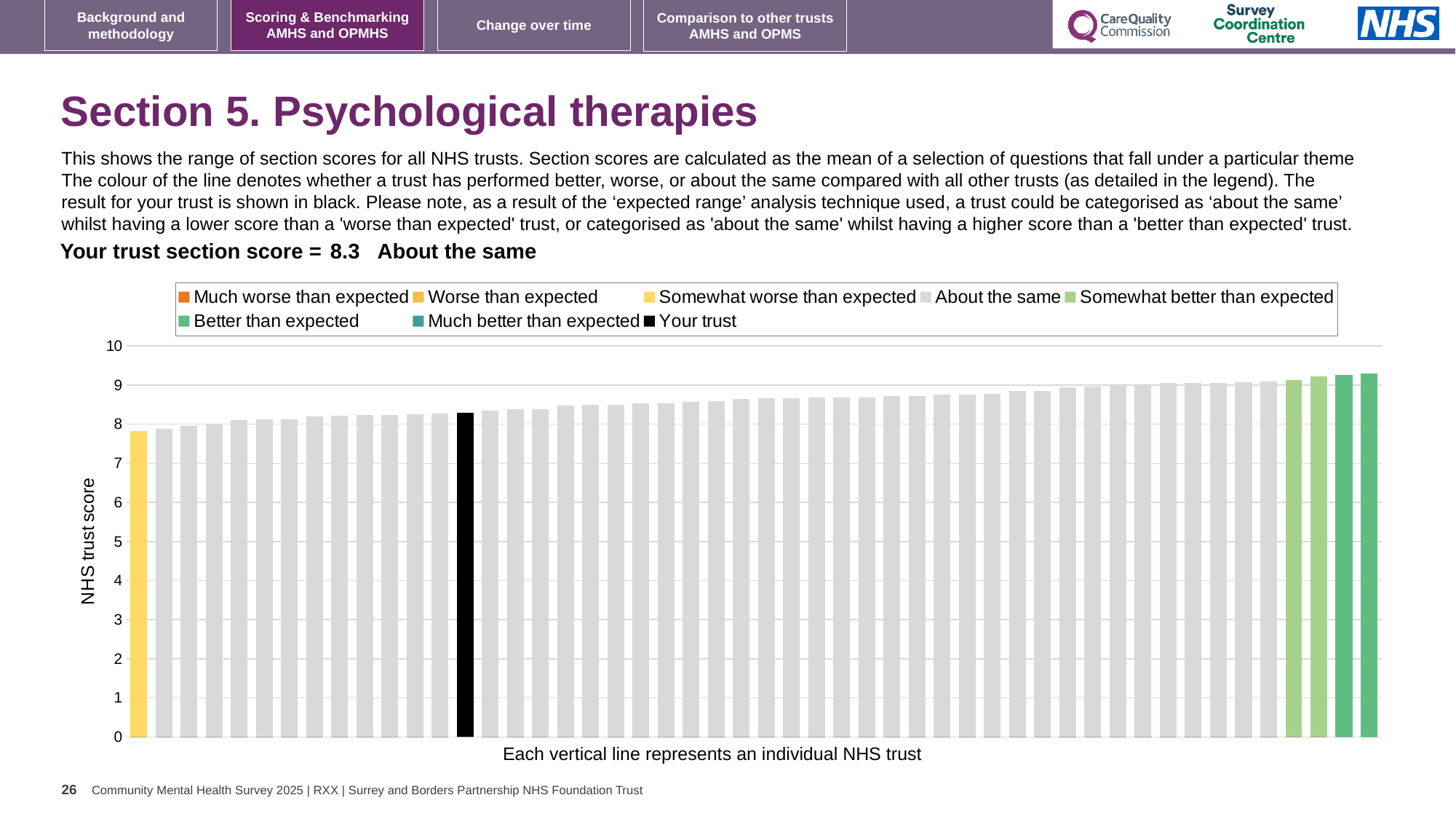
Is the value of the lowest bar greater or less than 5? greater Is the value of the black 'Your trust' bar greater or less than 8? greater What kind of chart is shown on the slide? bar chart Is the value of the leftmost (lowest) bar greater or less than 8? less How many bars in the chart are coloured green? 4 How many entries does the chart legend list? 8 What colour is the bar representing your trust? black What is the section score for your trust shown on the slide? 8.3 What is the label on the y axis of the chart? NHS trust score Do the bar values rise or fall from left to right along the x axis? rise